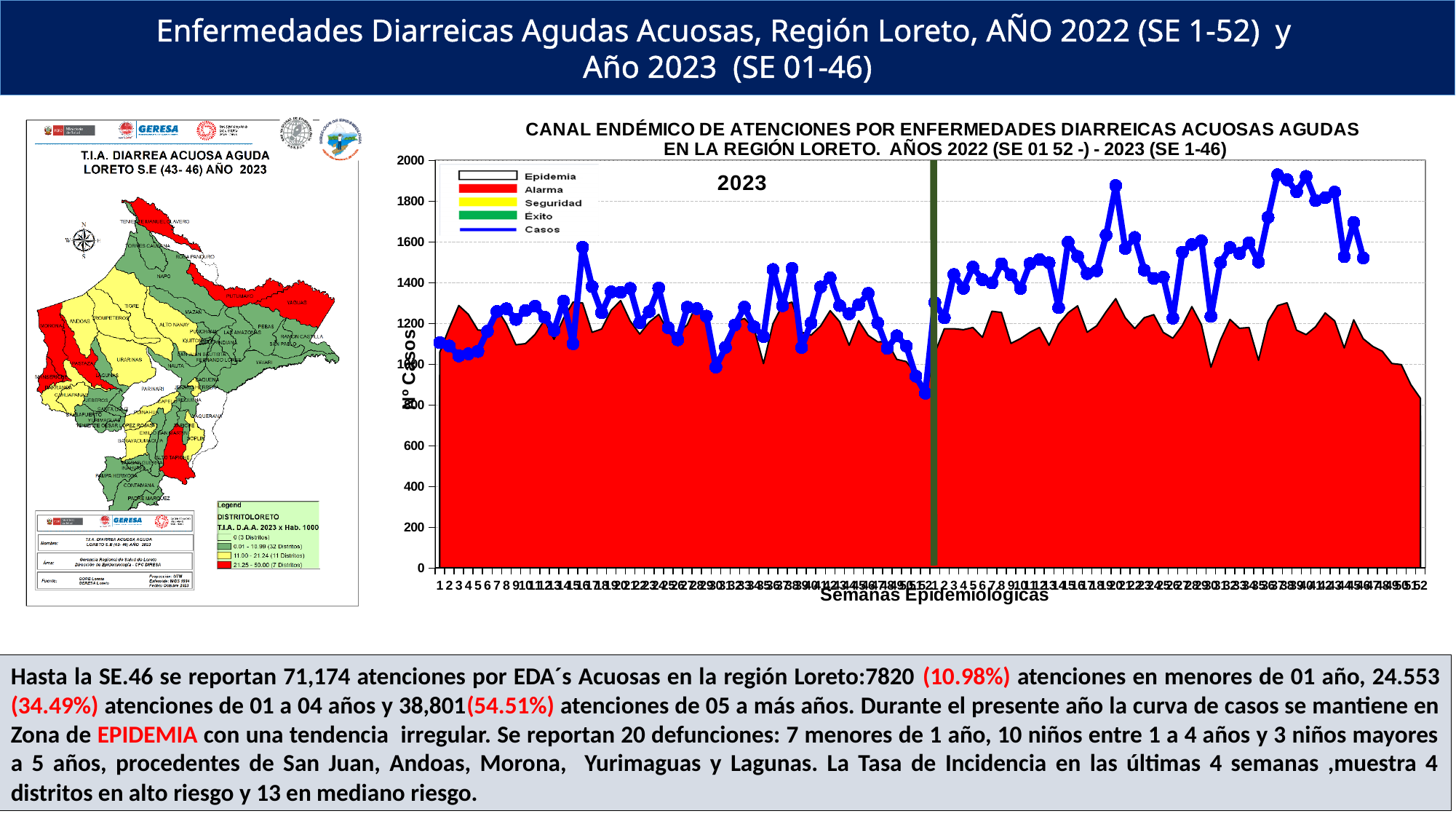
In the endemic channel chart, is the Casos value at week 46 of 2023 greater or less than 1400? greater What kind of chart is the 'Canal endémico de atenciones por enfermedades diarreicas acuosas agudas' chart? combination area and line chart How many entries does the legend of the endemic channel chart list? 5 In the endemic channel chart, is the highest point of the Casos line in 2023 greater or less than 1800? greater In the endemic channel chart, what is the label of the y axis? N° Casos In the endemic channel chart, does the Casos line generally rise or fall across the weeks of 2023? rise In the endemic channel chart, in which year does the Casos line reach its highest value, 2022 or 2023? 2023 In the endemic channel chart, what is the label of the x axis? Semanas Epidemiológicas In the endemic channel chart, is the Casos value at week 20 of 2023 higher or lower than the Casos value at week 20 of 2022? higher In the endemic channel chart, is the value of the Casos line at the last week of 2022 (week 52) greater or less than 1000? less